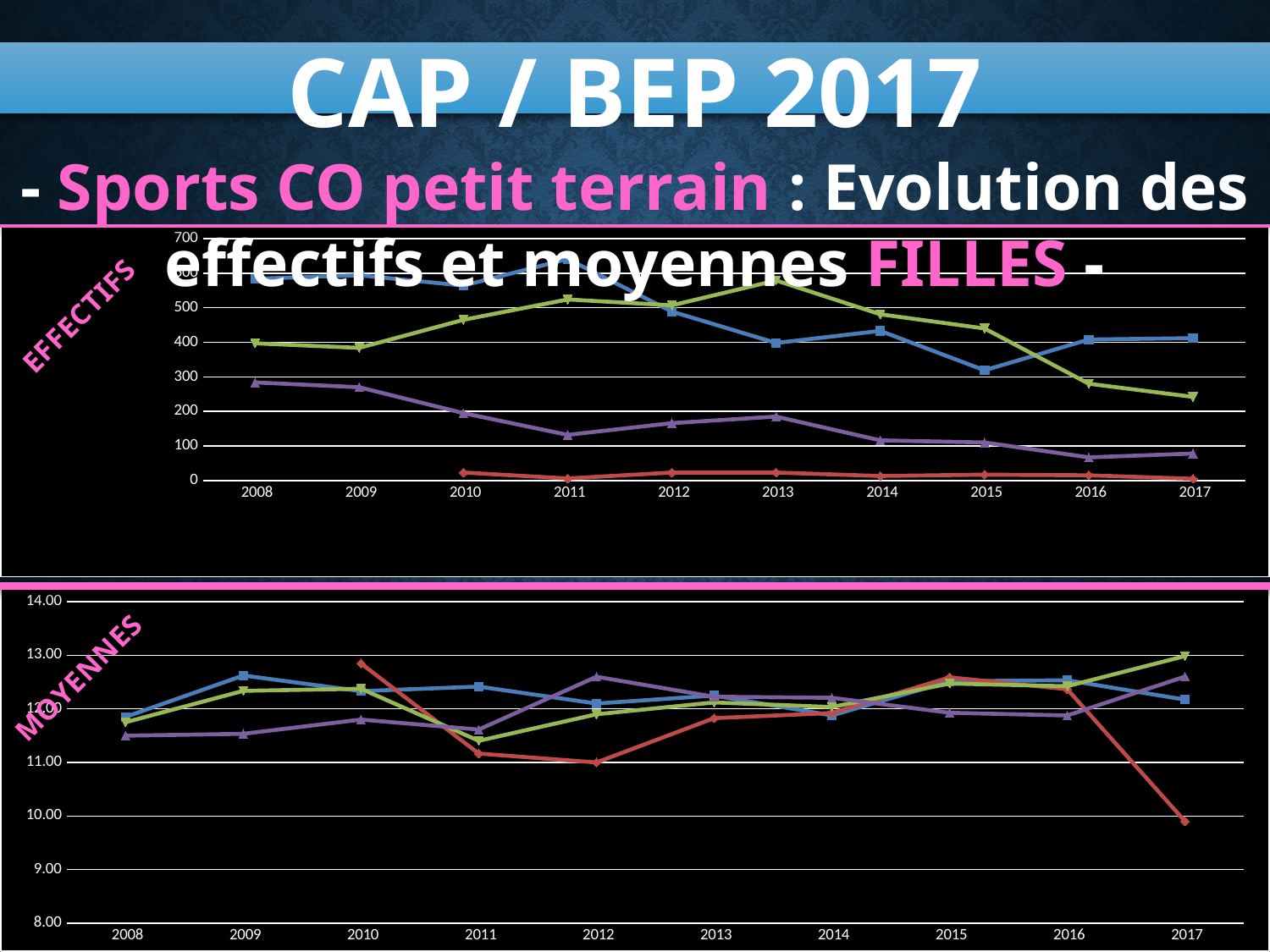
In the top chart (EFFECTIFS), does the green line rise or fall between 2013 and 2017? fall In the top chart (EFFECTIFS), how many years are shown on the x axis? 10 In the bottom chart (MOYENNES), how many lines are plotted? 4 In the top chart (EFFECTIFS), is the value of the green line in 2017 greater or less than 300? less In the bottom chart (MOYENNES), in which year does the red line reach its lowest value? 2017 In the bottom chart (MOYENNES), is the value of the blue line in 2009 greater or less than 12.00? greater In the top chart (EFFECTIFS), in which year does the green line reach its highest value? 2013 In the top chart (EFFECTIFS), which line is higher in 2017, the blue line or the green line? the blue line In the top chart (EFFECTIFS), in which year does the blue line reach its lowest value? 2015 In the top chart (EFFECTIFS), is the value of the red line in 2017 greater or less than 100? less What is the lowest value shown on the y axis of the bottom chart (MOYENNES)? 8.00 What type of chart is the top chart labelled EFFECTIFS? line chart